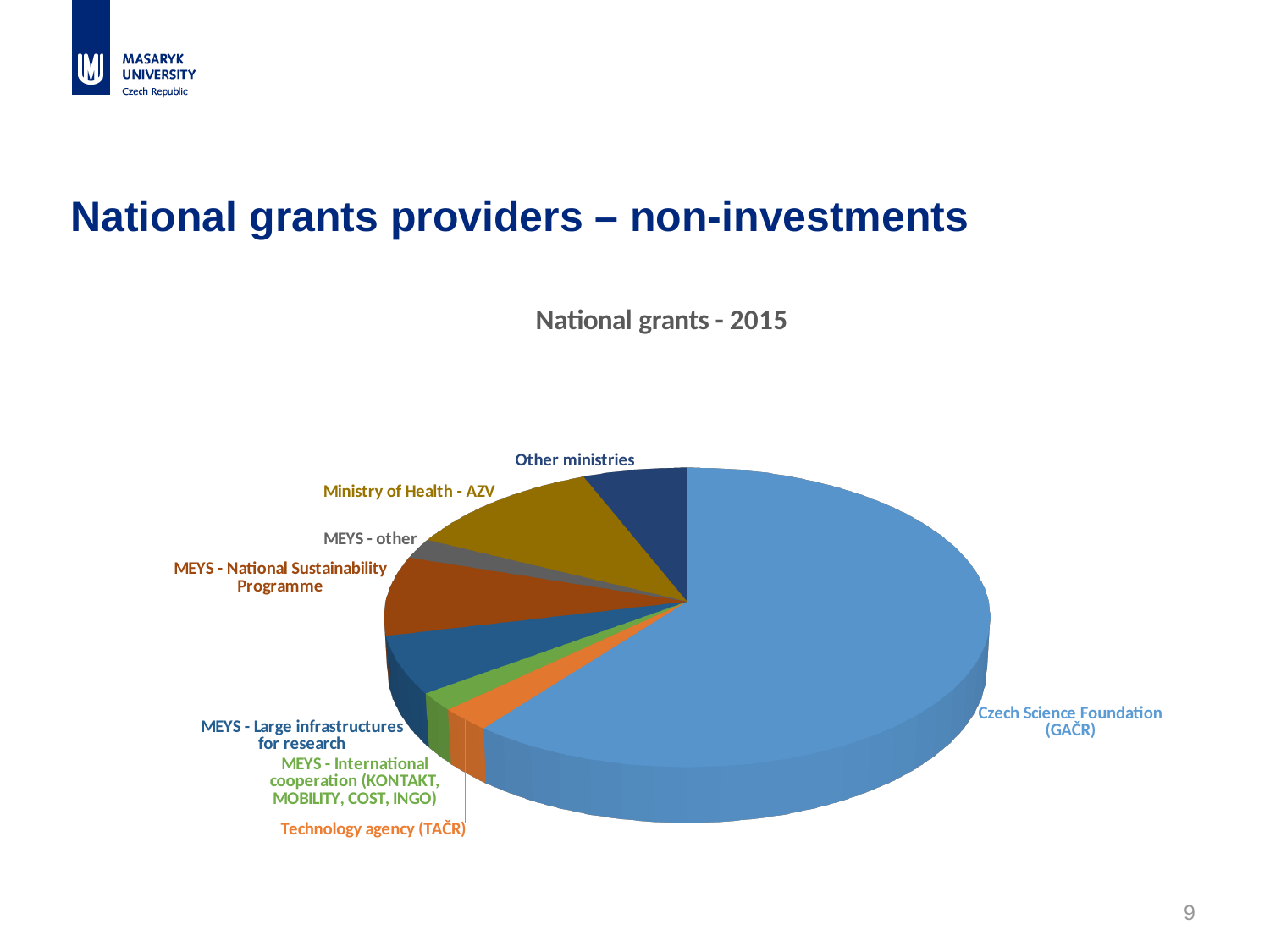
What is the title of the chart? National grants - 2015 Which is larger: the slice for Czech Science Foundation (GAČR) or the slice for Ministry of Health - AZV? Czech Science Foundation (GAČR) How many categories (slices) does the pie chart have? 8 What colour is the slice for Czech Science Foundation (GAČR)? light blue Which is larger: the slice for Ministry of Health - AZV or the slice for Other ministries? Ministry of Health - AZV Which is larger: the slice for MEYS - Large infrastructures for research or the slice for MEYS - other? MEYS - Large infrastructures for research What kind of chart is shown on the slide? pie chart Is the share of the pie for Czech Science Foundation (GAČR) greater or less than half? greater Which grant provider has the largest slice of the pie? Czech Science Foundation (GAČR)